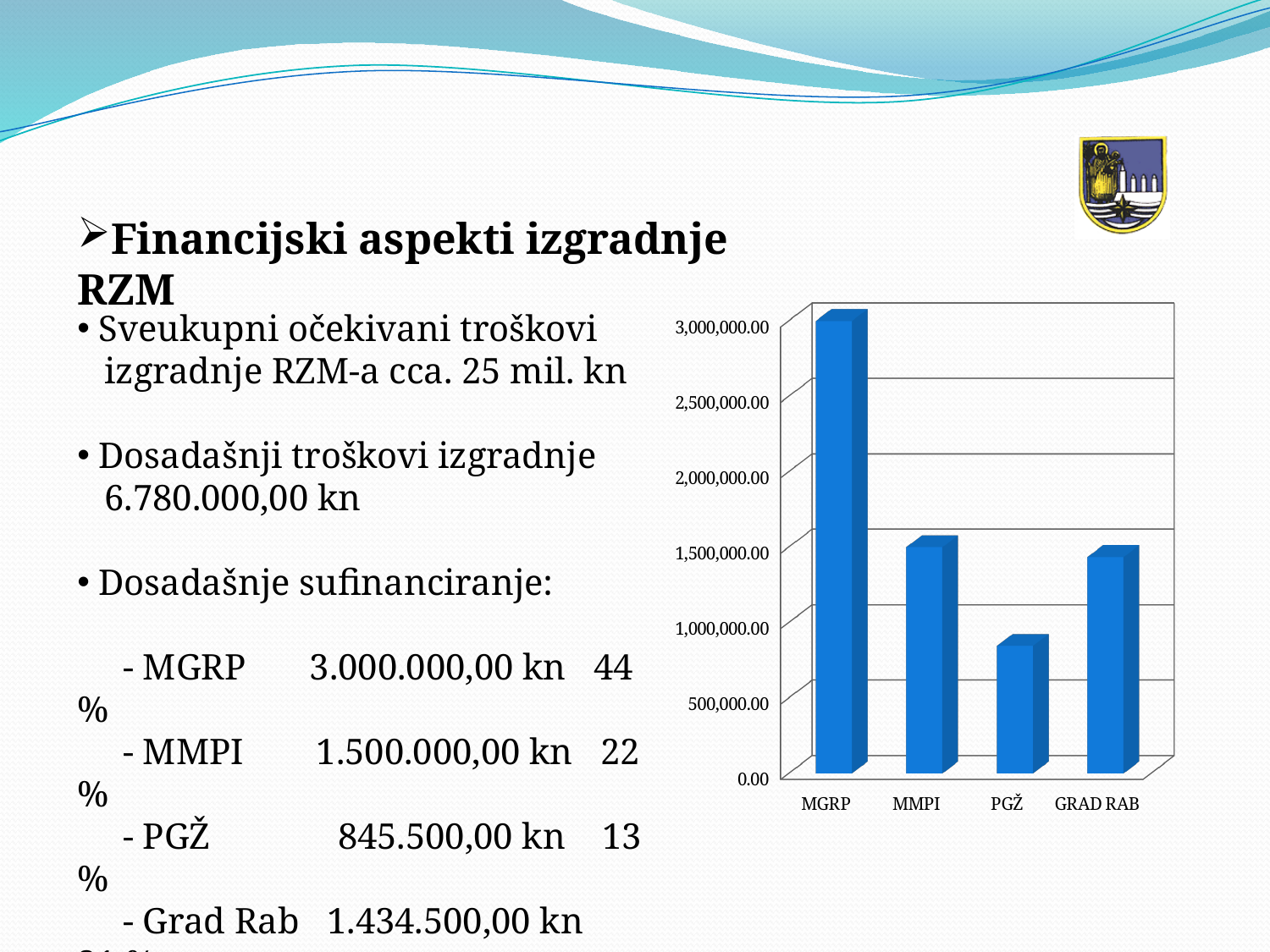
Is the value for PGŽ greater or less than 1,000,000.00? less Is the value for PGŽ greater or less than 500,000.00? greater Which is larger, the bar for MMPI or the bar for PGŽ? MMPI Which category has the highest bar in the chart? MGRP Which is larger, the bar for MGRP or the bar for GRAD RAB? MGRP How many categories are shown on the x axis of the chart? 4 Which category has the lowest bar in the chart? PGŽ What value does the MGRP bar reach on the chart? 3,000,000.00 Is the value for GRAD RAB greater or less than 1,000,000.00? greater What is the difference between the MGRP bar and the MMPI bar? 1,500,000.00 What kind of chart is shown on the slide? bar chart What value does the MMPI bar reach on the chart? 1,500,000.00